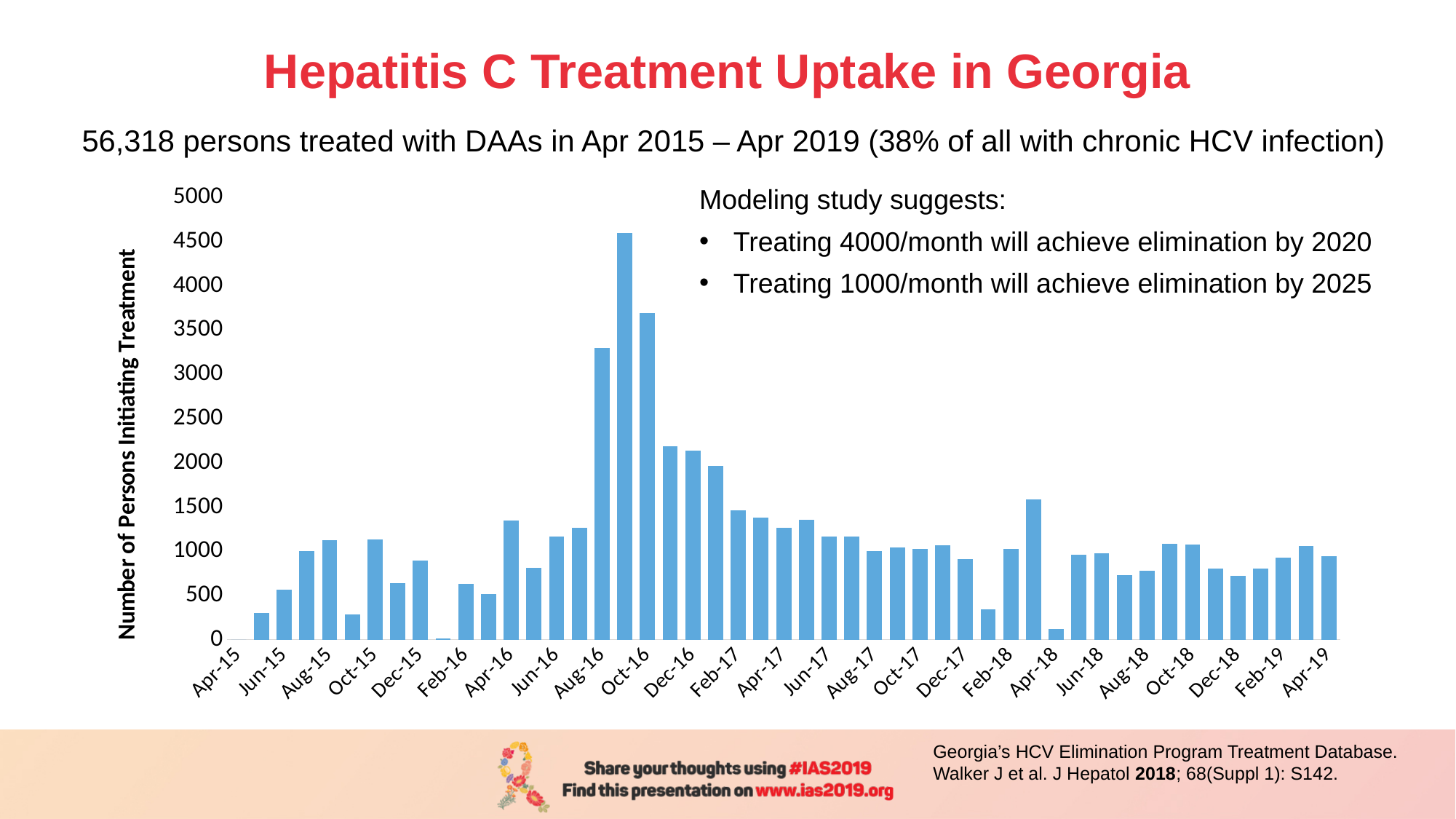
What is the title of the y axis of the chart? Number of Persons Initiating Treatment Is the value for Oct-16 greater or less than 3500? greater Is the value for Dec-15 greater or less than 1000? less Which is larger, the value for Oct-16 or the value for Dec-16? Oct-16 Is the value for Aug-16 greater or less than 3000? greater Which is larger, the value for Feb-18 or the value for Apr-18? Feb-18 What kind of chart is shown on the slide? bar chart Between Oct-16 and Feb-17, do the bars rise or fall? fall In which year does the tallest bar of the chart occur? 2016